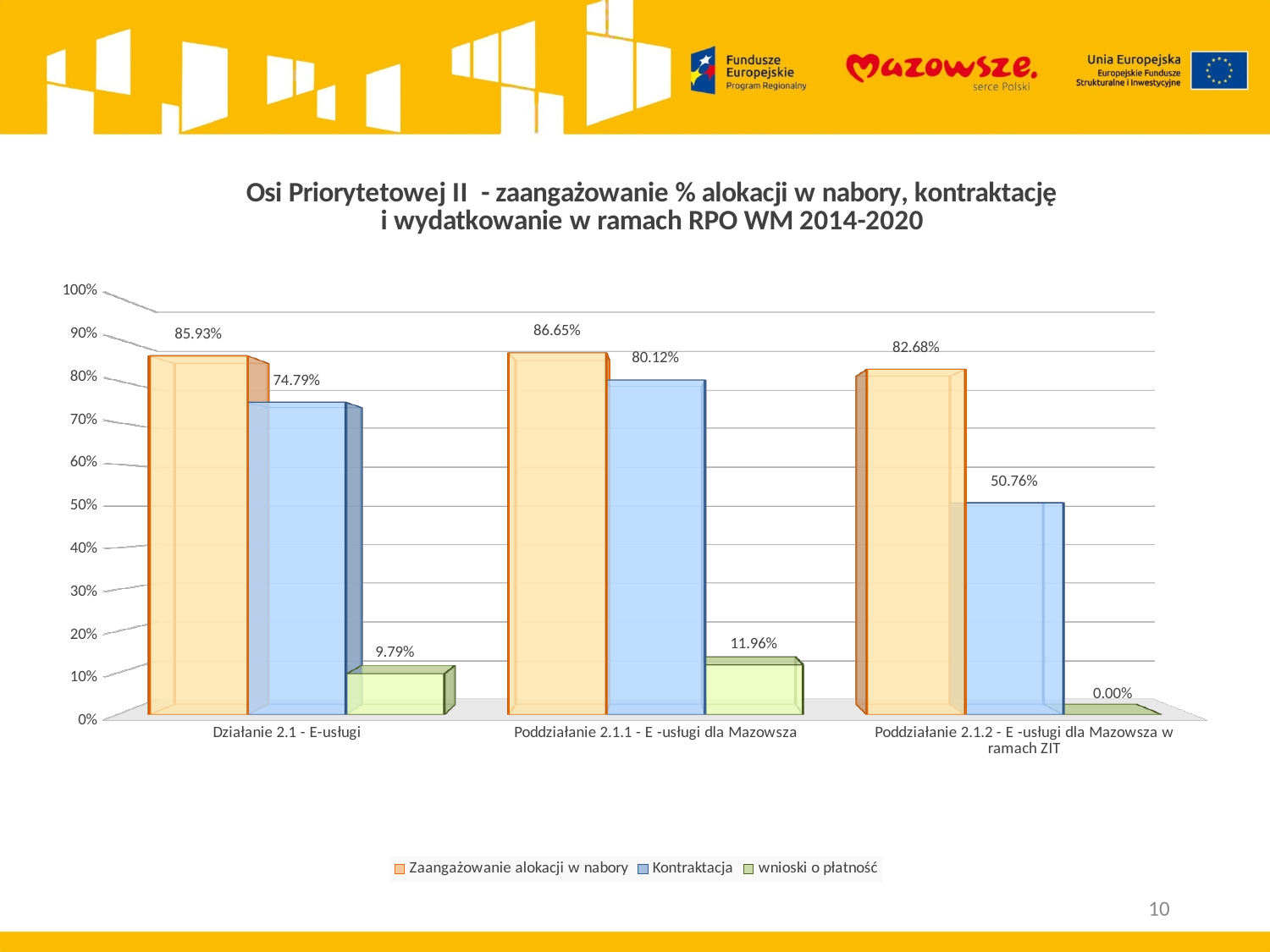
What is the value of wnioski o płatność for Poddziałanie 2.1.2 - E -usługi dla Mazowsza w ramach ZIT? 0.00% Which category has the lowest value for Kontraktacja? Poddziałanie 2.1.2 - E -usługi dla Mazowsza w ramach ZIT How many categories are shown on the x axis? 3 What is the value of Zaangażowanie alokacji w nabory for Działanie 2.1 - E-usługi? 85.93% Which series is shown in green in the legend? wnioski o płatność What is the difference between Zaangażowanie alokacji w nabory and Kontraktacja for Poddziałanie 2.1.2 - E -usługi dla Mazowsza w ramach ZIT? 31.92% How many series does the legend list? 3 What is the value of Kontraktacja for Poddziałanie 2.1.1 - E -usługi dla Mazowsza? 80.12% What kind of chart is shown on the slide? bar chart Which is larger: wnioski o płatność for Działanie 2.1 - E-usługi or for Poddziałanie 2.1.1 - E -usługi dla Mazowsza? Poddziałanie 2.1.1 - E -usługi dla Mazowsza Is the value of Kontraktacja for Działanie 2.1 - E-usługi greater or less than 70%? greater Which category has the highest value for Zaangażowanie alokacji w nabory? Poddziałanie 2.1.1 - E -usługi dla Mazowsza